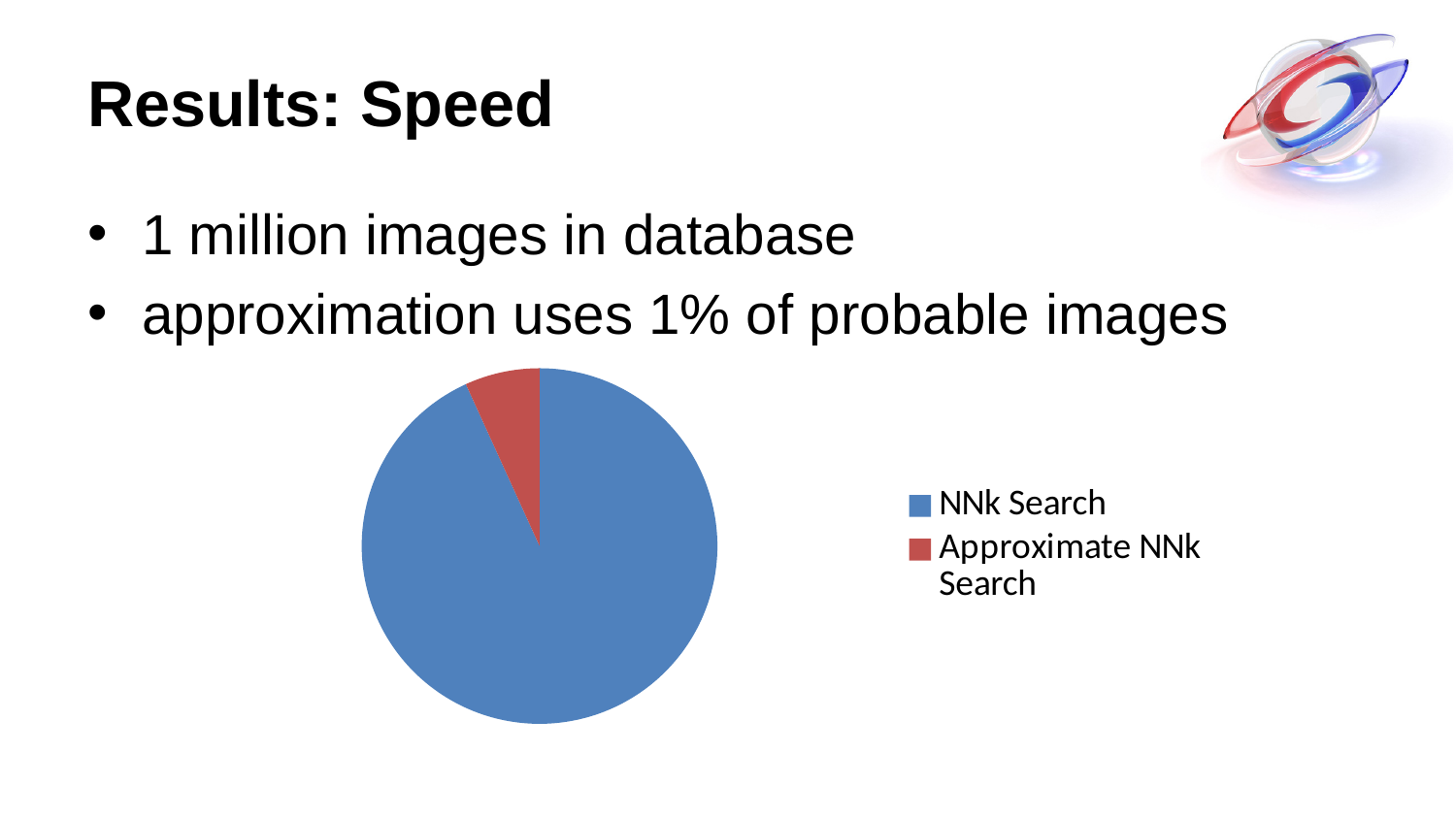
How many slices does the pie chart have? 2 How many entries does the legend of the pie chart list? 2 What kind of chart is shown on the slide? pie chart Which slice of the pie chart is the smallest? Approximate NNk Search Which slice of the pie chart is the largest? NNk Search What colour is the Approximate NNk Search slice in the pie chart? red Which is larger in the pie chart, NNk Search or Approximate NNk Search? NNk Search What colour is the NNk Search slice in the pie chart? blue